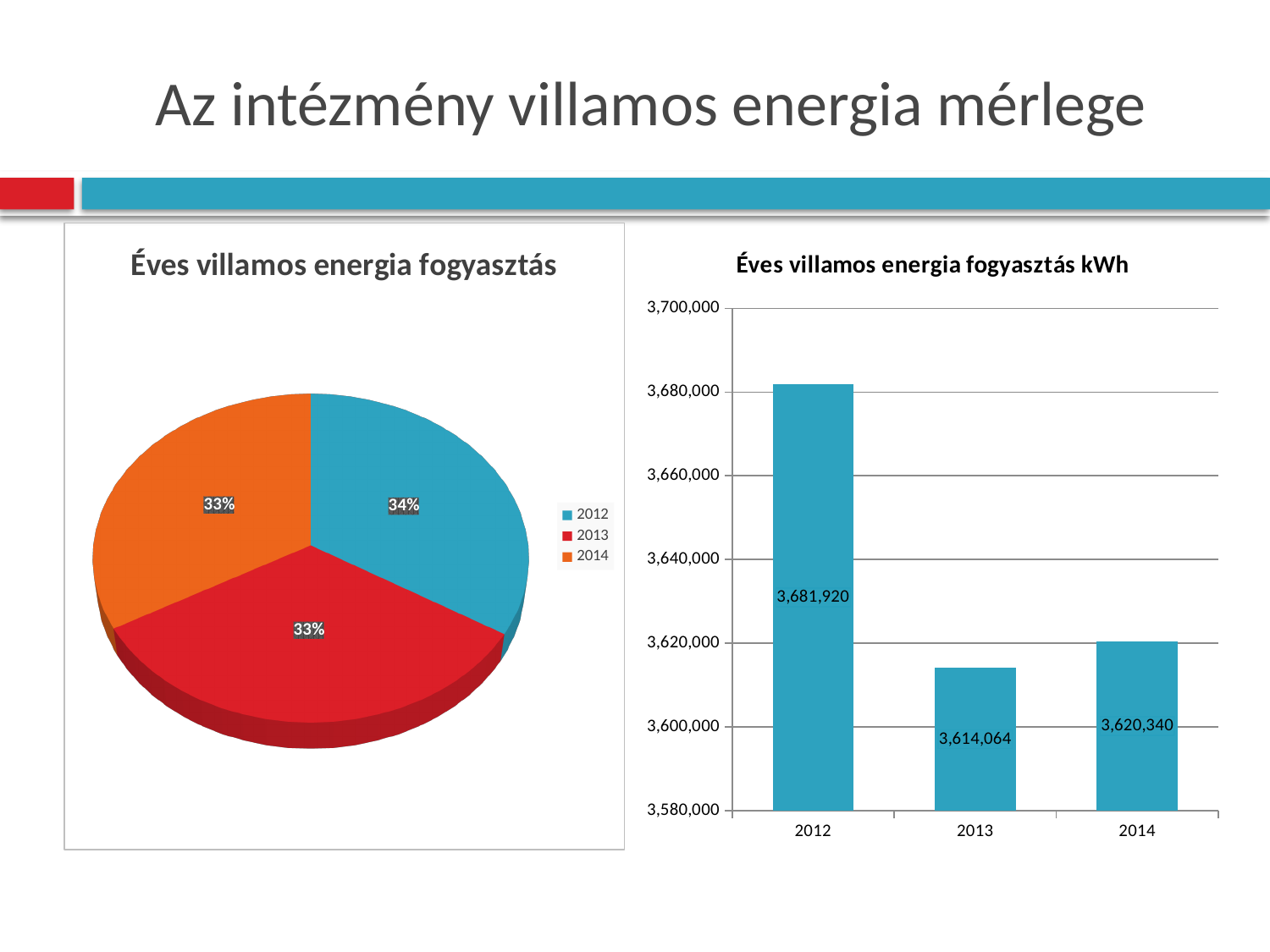
In the bar chart titled "Éves villamos energia fogyasztás kWh", what is the value for 2014? 3,620,340 In the bar chart on the right, how many years are shown on the x axis? 3 In the bar chart on the right, which year has the highest value? 2012 What kind of chart is the chart on the left of the slide? Pie chart In the bar chart titled "Éves villamos energia fogyasztás kWh", what is the value for 2012? 3,681,920 In the bar chart on the right, what is the difference between the values for 2012 and 2013? 67,856 In the pie chart on the left, how many entries does the legend list? 3 In the bar chart on the right, is the value for 2012 greater or less than 3,660,000? greater In the bar chart on the right, which is larger, the value for 2013 or the value for 2014? 2014 In the bar chart titled "Éves villamos energia fogyasztás kWh", what is the value for 2013? 3,614,064 In the pie chart titled "Éves villamos energia fogyasztás", what share does 2012 have? 34% In the bar chart on the right, which year has the lowest value? 2013